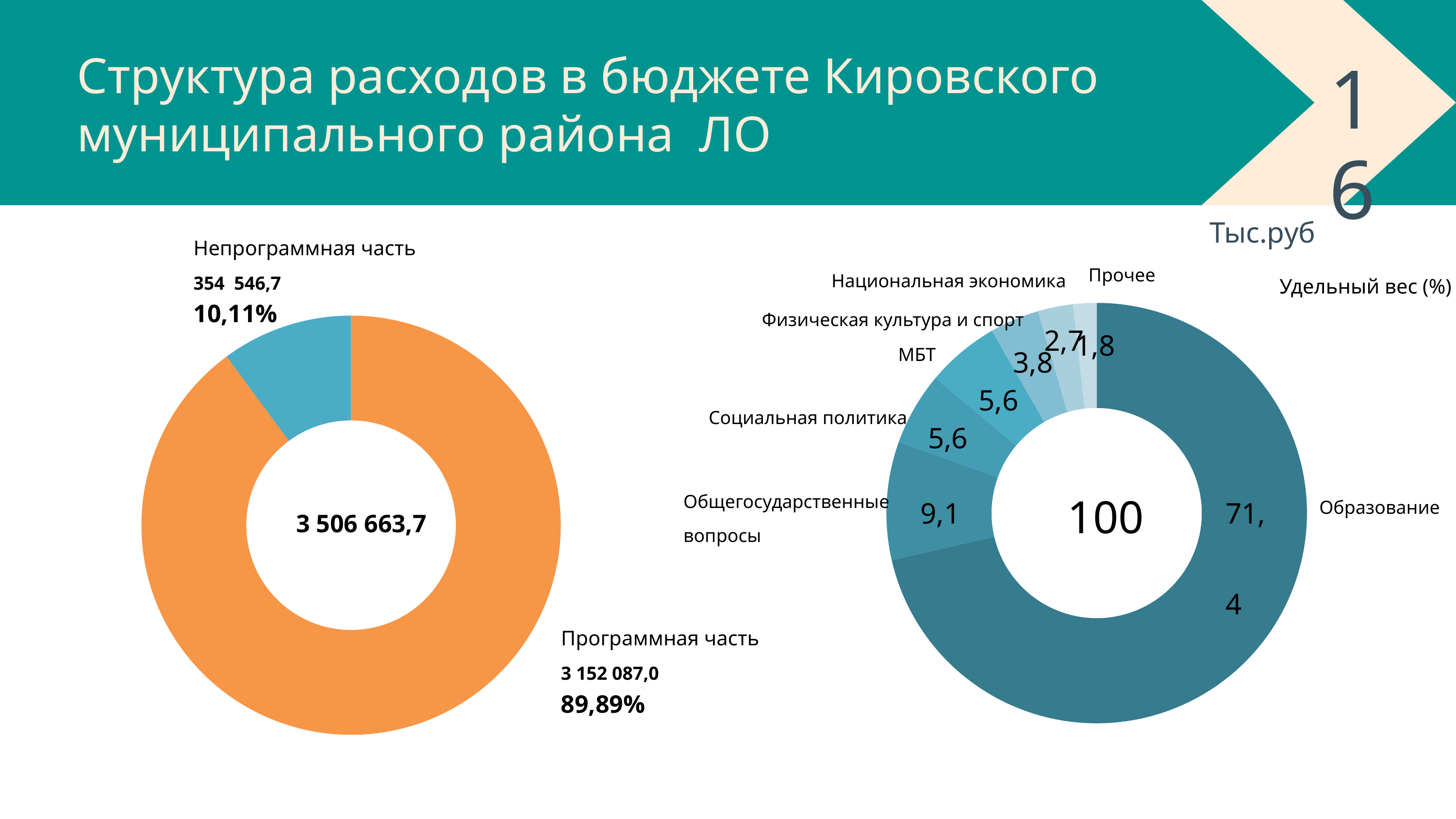
In the left donut chart, which of the two parts is larger, Программная часть or Непрограммная часть? Программная часть What type of chart is used on the left side of the slide? Donut chart In the right chart (Удельный вес (%)), what is the difference between the shares of Физическая культура и спорт and Национальная экономика? 1,1 In the right chart (Удельный вес (%)), which category has the largest share? Образование In the right chart (Удельный вес (%)), how many categories are shown? 7 In the left donut chart, what total value is printed in the centre of the ring? 3 506 663,7 In the right chart (Удельный вес (%)), what share is shown for Образование? 71,4 In the left donut chart, what value is shown for Непрограммная часть? 354 546,7 In the right chart (Удельный вес (%)), which category has the smallest share? Прочее In the left donut chart, what percentage is shown for Программная часть? 89,89% In the right chart (Удельный вес (%)), what share is shown for Общегосударственные вопросы? 9,1 In the left donut chart, what is the difference in percentage points between Программная часть and Непрограммная часть? 79,78